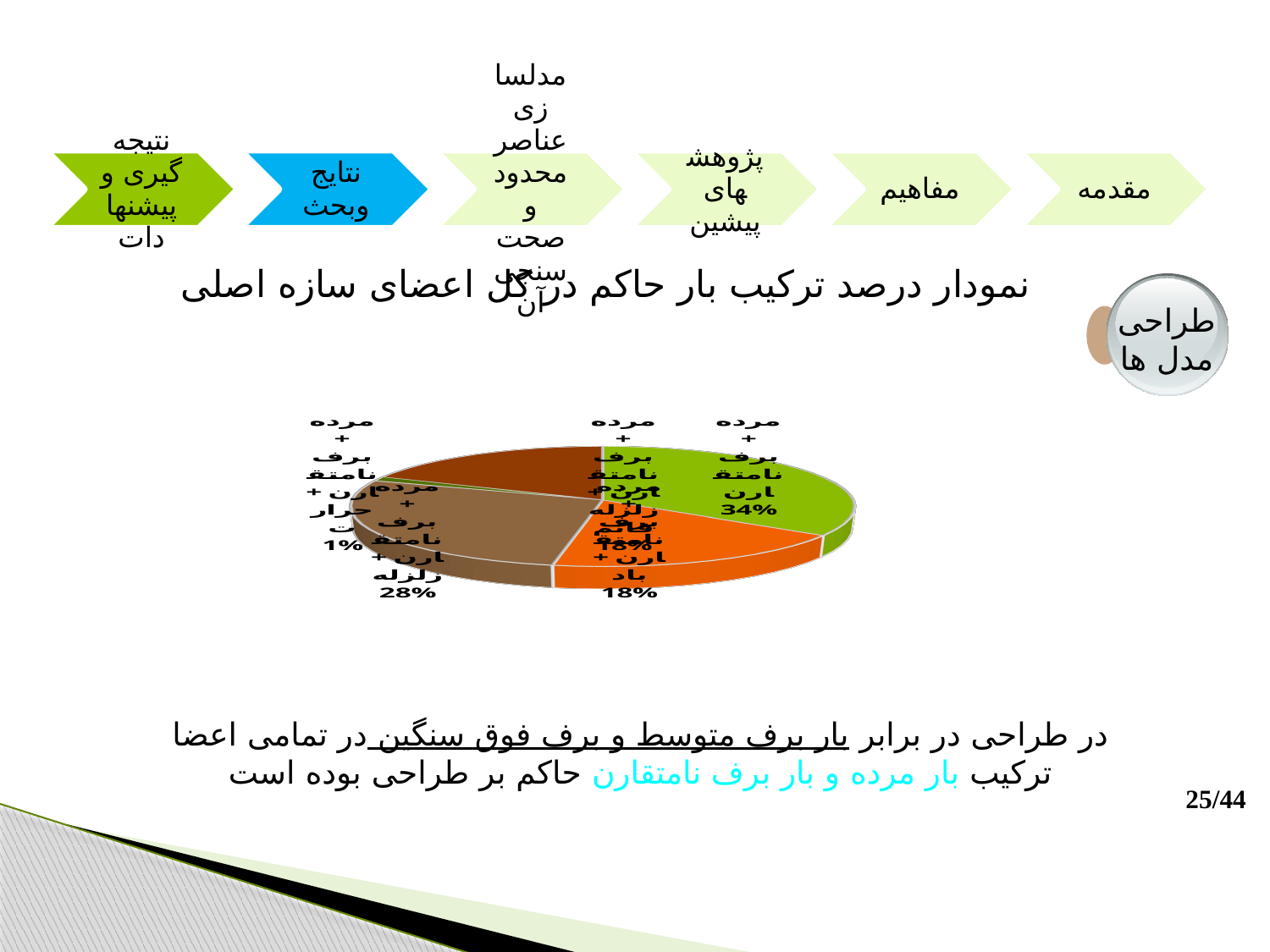
What is the title of the chart on the slide? نمودار درصد ترکیب بار حاکم در کل اعضای سازه اصلی What percentage is shown for the slice labelled مرده + برف نامتقارن + باد? 18% What percentage is shown for the slice labelled مرده + برف نامتقارن + زلزله? 28% Which slice of the pie chart has the smallest share? مرده + حرارت Which slice of the pie chart has the largest share? مرده + برف نامتقارن What is the difference in percentage points between the مرده + برف نامتقارن slice and the مرده + برف نامتقارن + زلزله slice? 6 What kind of chart is shown on the slide? pie chart What colour is the slice labelled مرده + برف نامتقارن 34%? green What percentage is shown for the slice labelled مرده + برف نامتقارن? 34% Which is larger: the share for مرده + برف نامتقارن + زلزله or the share for مرده + برف نامتقارن + باد? مرده + برف نامتقارن + زلزله What percentage is shown for the slice labelled مرده + حرارت? 1% How many slices does the pie chart have? 5